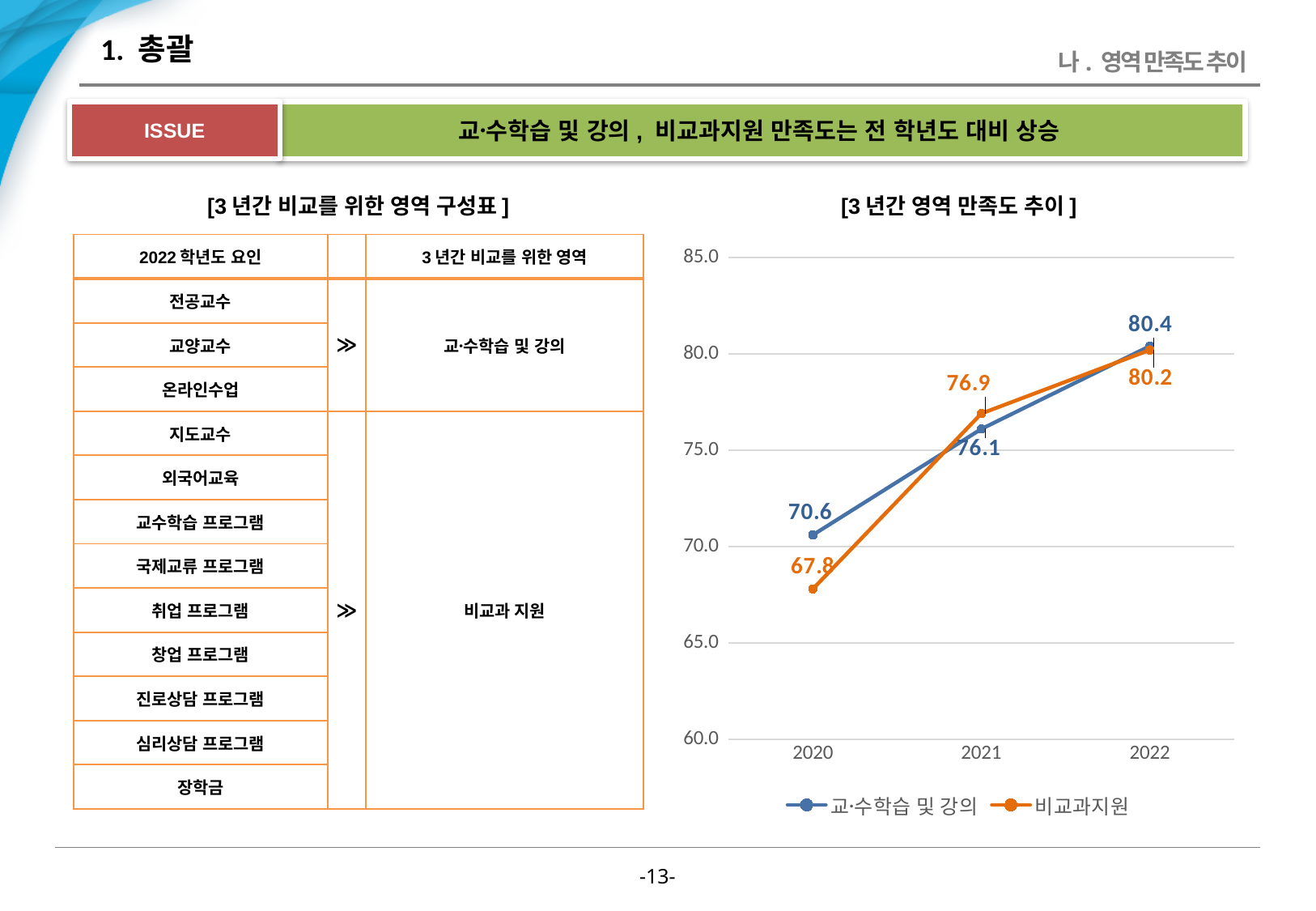
What kind of chart is shown? line chart How many series does the legend list? 2 What is the difference between the 2022 and 2020 values for 교·수학습 및 강의? 9.8 What is the difference between the 2021 and 2020 values for 비교과지원? 9.1 In which year is the value for 비교과지원 lowest? 2020 How many years are shown on the x axis? 3 What is the value for 교·수학습 및 강의 in 2020? 70.6 In 2020, which series has the larger value, 교·수학습 및 강의 or 비교과지원? 교·수학습 및 강의 Is the value for 비교과지원 in 2020 greater or less than 70.0? less In which year is the value for 교·수학습 및 강의 highest? 2022 What is the value for 비교과지원 in 2021? 76.9 What is the value for 비교과지원 in 2022? 80.2